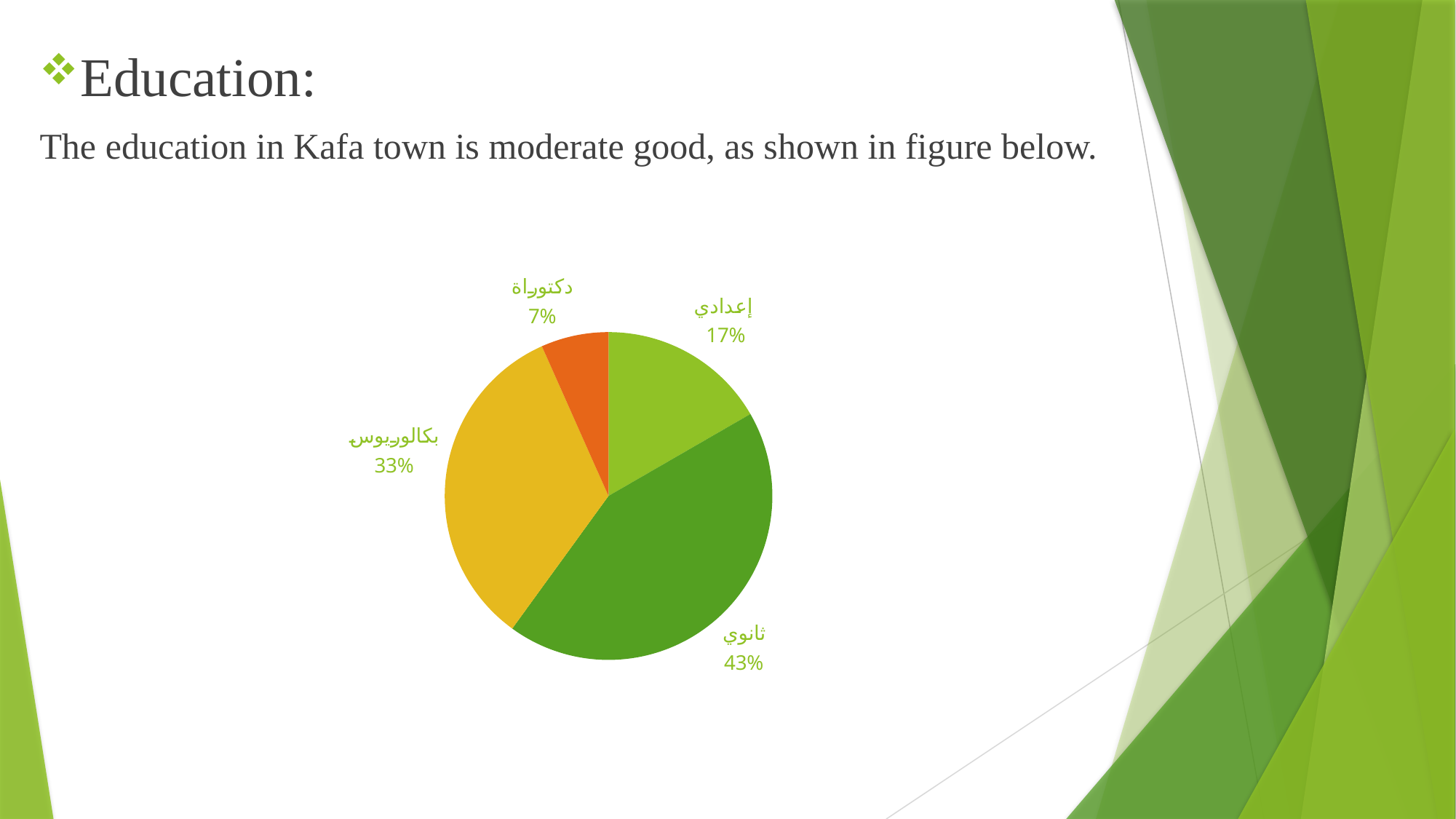
How many slices does the pie chart have? 4 Which is larger, the share for إعدادي or the share for دكتوراة? إعدادي What percentage is shown for بكالوريوس? 33% What percentage is shown for ثانوي? 43% What percentage is shown for دكتوراة? 7% What is the difference in percentage points between إعدادي and دكتوراة? 10 What percentage is shown for إعدادي? 17% Which category has the smallest share of the pie? دكتوراة Which category has the largest share of the pie? ثانوي What colour is the slice for دكتوراة? orange What is the difference in percentage points between ثانوي and بكالوريوس? 10 What kind of chart is shown on the slide? pie chart